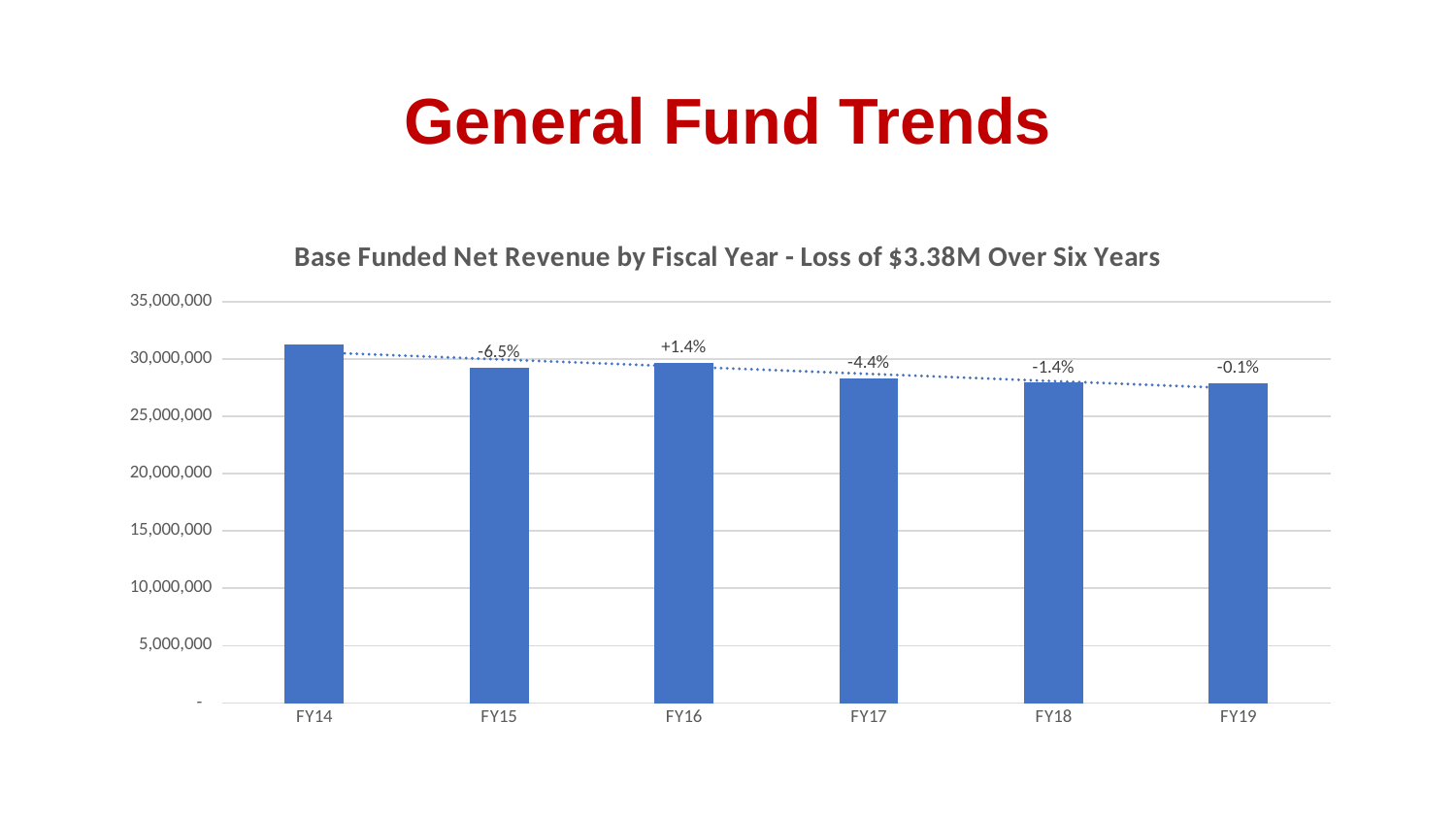
What percentage change is labelled above the FY15 bar? -6.5% What is the title of the chart? Base Funded Net Revenue by Fiscal Year - Loss of $3.38M Over Six Years Is the value for FY14 greater or less than 30,000,000? greater What kind of chart is shown on the slide? bar chart Which is larger, the value for FY16 or the value for FY17? FY16 Which fiscal year has the highest base funded net revenue? FY14 Do the values generally rise or fall from FY14 to FY19? fall Is the value for FY17 greater or less than 30,000,000? less What percentage change is labelled above the FY19 bar? -0.1% What percentage change is labelled above the FY17 bar? -4.4% What percentage change is labelled above the FY16 bar? +1.4% How many fiscal years are plotted on the chart? 6